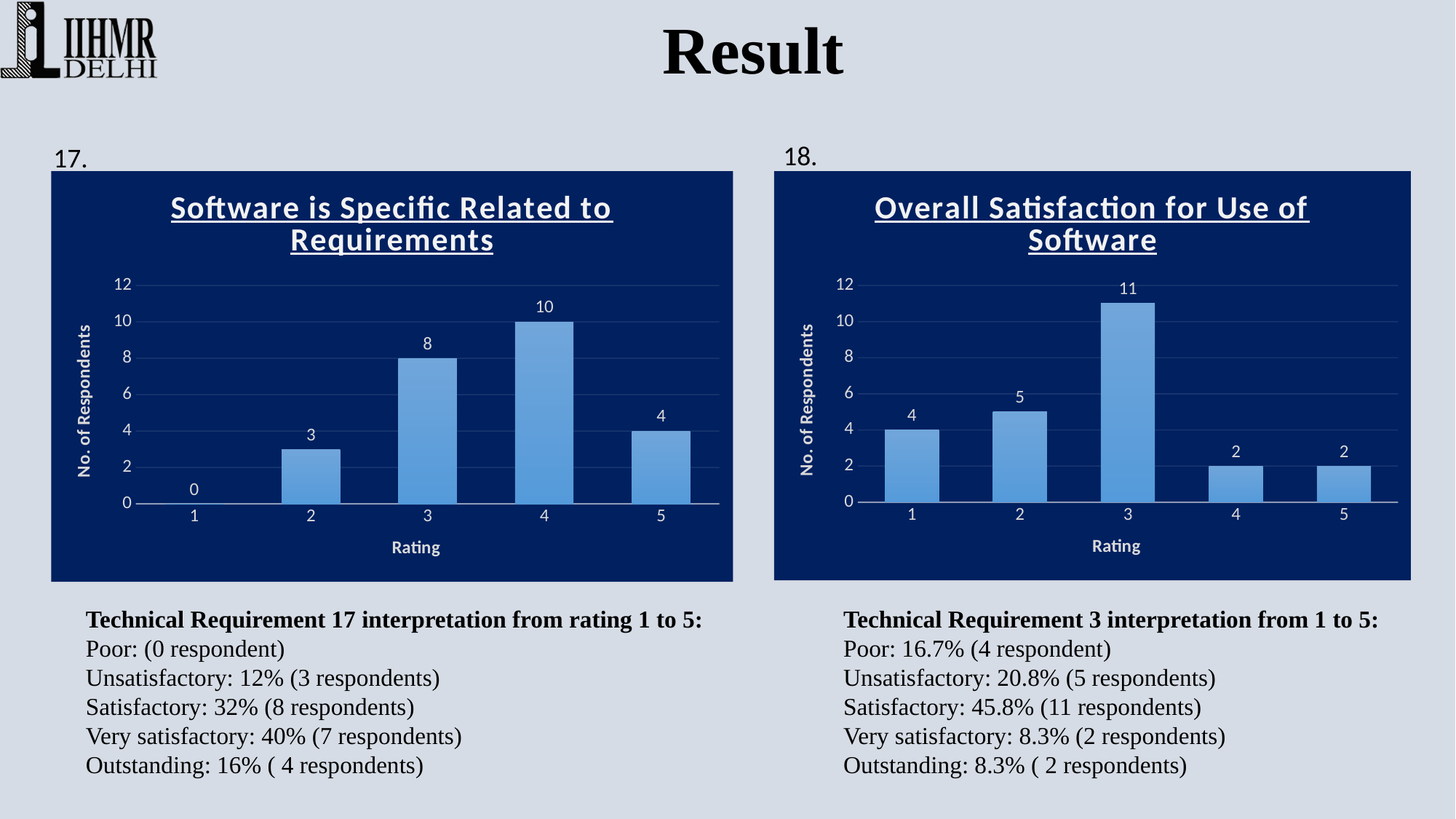
In the 'Overall Satisfaction for Use of Software' chart, how many respondents gave a rating of 3? 11 In the 'Software is Specific Related to Requirements' chart, how many respondents gave a rating of 2? 3 In the 'Overall Satisfaction for Use of Software' chart, what is the difference between the number of respondents for rating 3 and rating 2? 6 In the 'Software is Specific Related to Requirements' chart, what is the difference between the number of respondents for rating 4 and rating 3? 2 In the 'Overall Satisfaction for Use of Software' chart, which rating has the highest number of respondents? 3 In the 'Software is Specific Related to Requirements' chart, which rating has the highest number of respondents? 4 What type of chart is the 'Software is Specific Related to Requirements' chart? Bar chart In the 'Software is Specific Related to Requirements' chart, which rating has the lowest number of respondents? 1 How many rating categories are shown on the x axis of the 'Overall Satisfaction for Use of Software' chart? 5 In the 'Overall Satisfaction for Use of Software' chart, which is larger: the number of respondents for rating 2 or rating 4? Rating 2 In the 'Software is Specific Related to Requirements' chart, how many respondents gave a rating of 4? 10 In the 'Overall Satisfaction for Use of Software' chart, how many respondents gave a rating of 1? 4